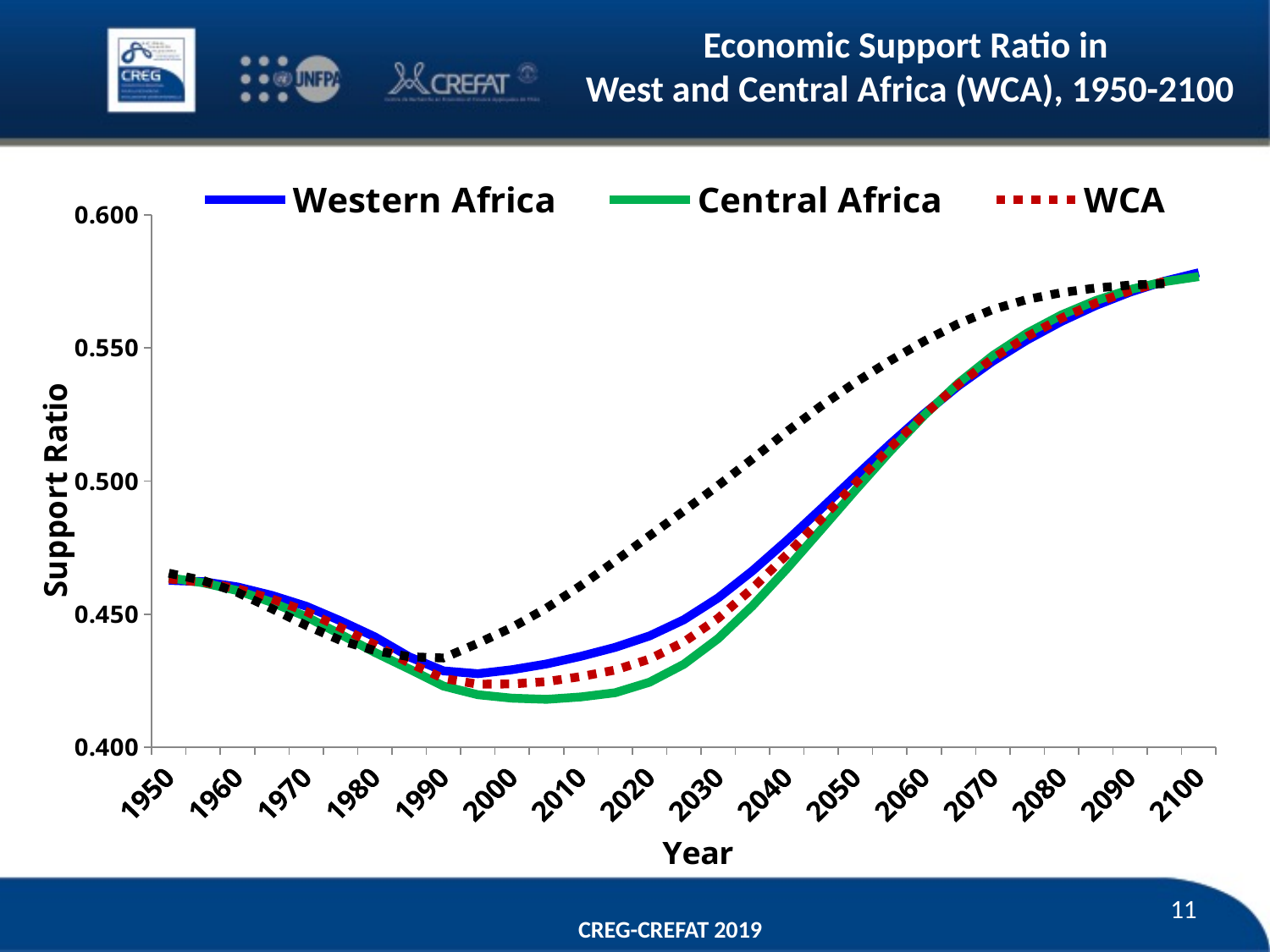
What kind of chart is shown on the slide? line chart Which legend series has the lowest value around 2010? Central Africa Is the value for Central Africa in 2010 greater or less than 0.450? less Does the Central Africa line rise or fall between 2010 and 2100? rise How many year labels are shown on the x axis? 16 Is the value for WCA in 1950 greater or less than 0.450? greater What is the title of the chart? Economic Support Ratio in West and Central Africa (WCA), 1950-2100 How many series does the legend list? 3 In 2010, which is higher: Western Africa or Central Africa? Western Africa Is the value for Western Africa in 2100 greater or less than 0.550? greater What colour is the Western Africa line? blue